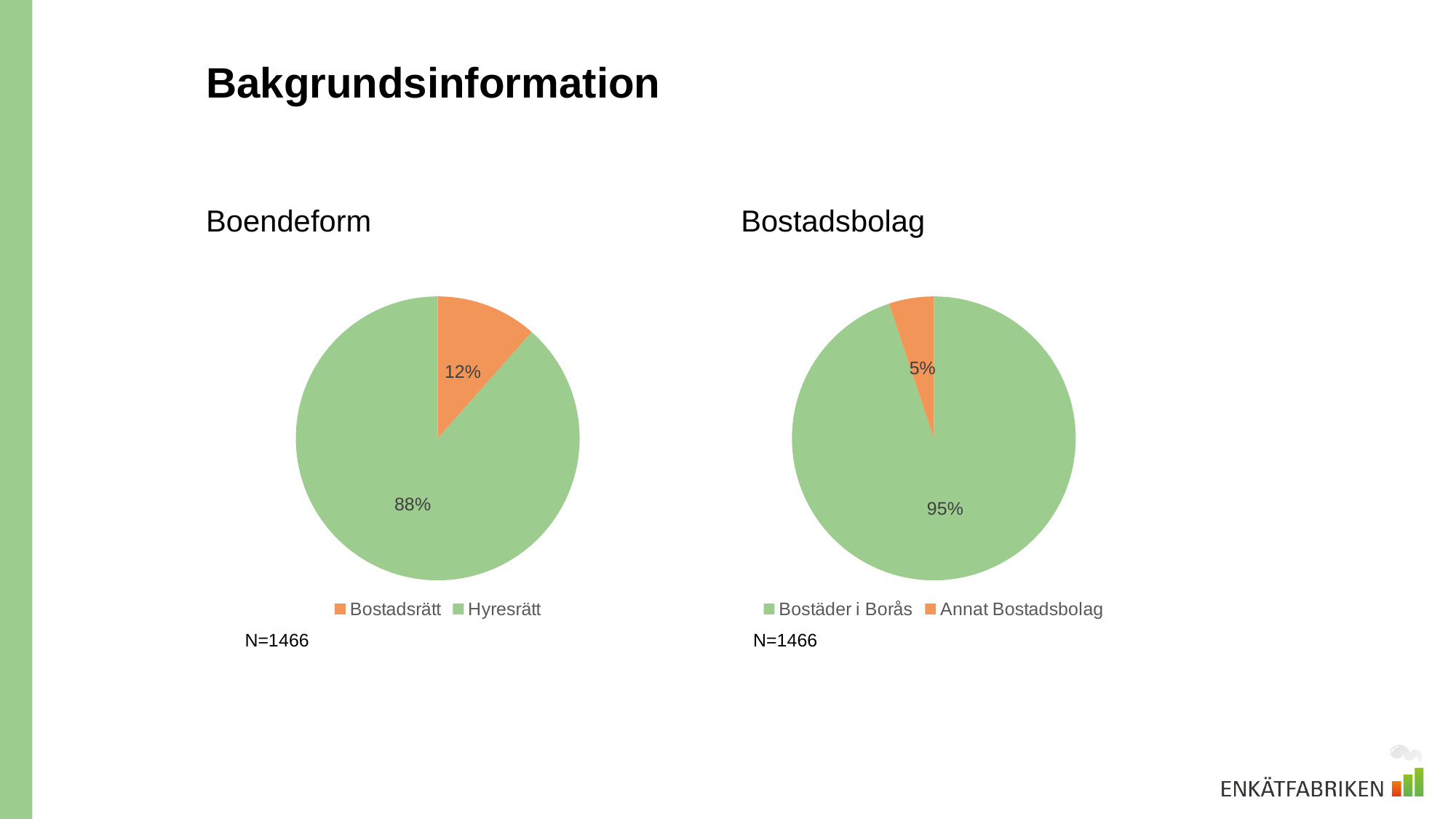
In the Bostadsbolag chart, what share is Bostäder i Borås? 95% In the Boendeform chart, what colour is the Bostadsrätt slice? Orange What type of chart is used for Boendeform? Pie chart In the Bostadsbolag chart, which category has the smallest slice? Annat Bostadsbolag In the Boendeform chart, what is the difference in percentage points between Hyresrätt and Bostadsrätt? 76 percentage points In the Boendeform chart, what share is Hyresrätt? 88% In the Boendeform chart, what share is Bostadsrätt? 12% In the Bostadsbolag chart, what is the difference in percentage points between Bostäder i Borås and Annat Bostadsbolag? 90 percentage points In the Bostadsbolag chart, what share is Annat Bostadsbolag? 5% Which is larger: the Bostadsrätt slice in the Boendeform chart or the Annat Bostadsbolag slice in the Bostadsbolag chart? Bostadsrätt In the Boendeform chart, which category has the largest slice? Hyresrätt How many categories does the Bostadsbolag chart show? 2